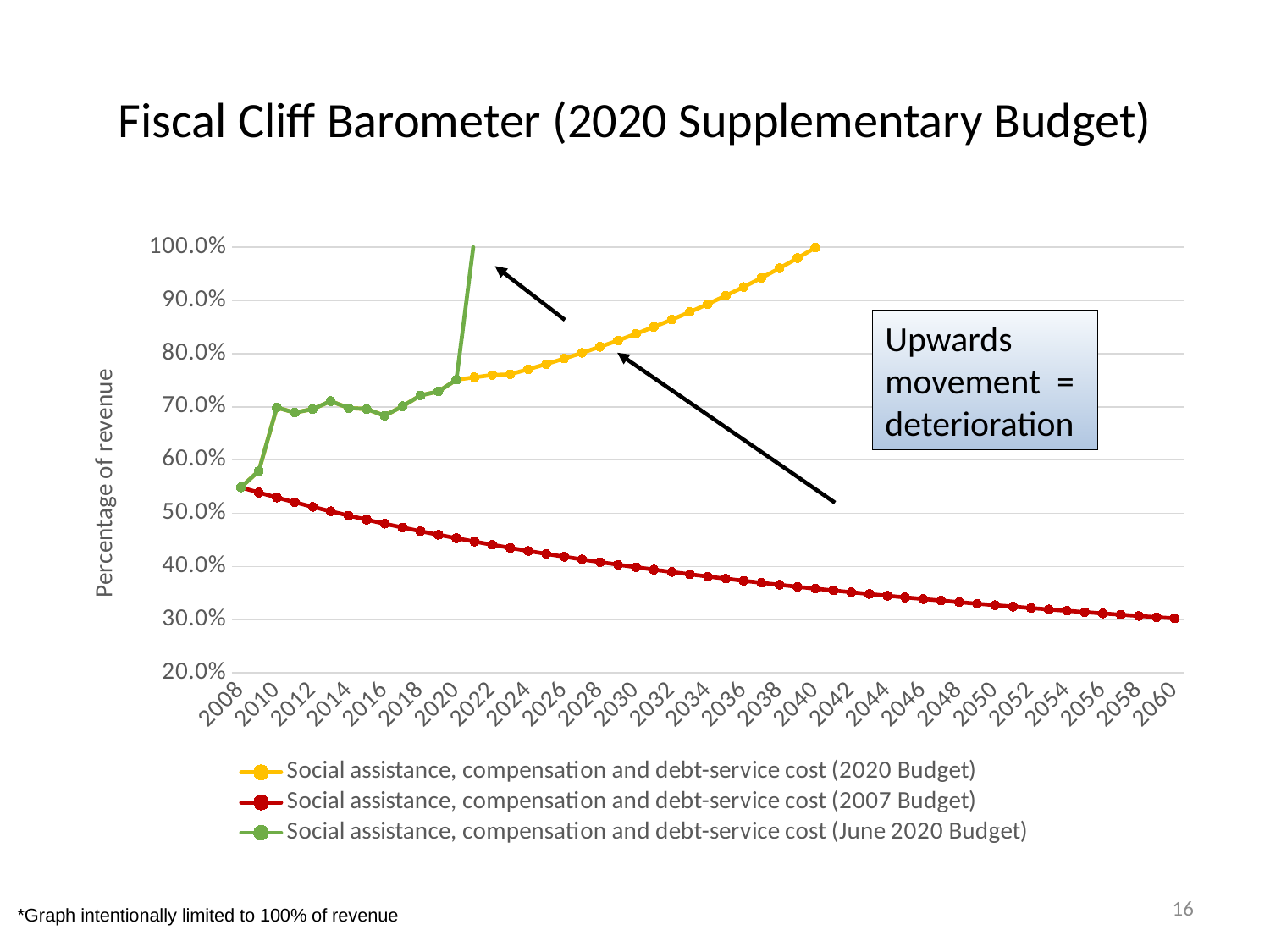
What is the title of the chart? Fiscal Cliff Barometer (2020 Supplementary Budget) Is the value for the June 2020 Budget series in 2008 greater or less than 50.0%? greater Is the value for the 2007 Budget series in 2020 greater or less than 50.0%? less How many series does the legend list? 3 Is the value for the 2007 Budget series in 2050 greater or less than 30.0%? greater Does the 'Social assistance, compensation and debt-service cost (2007 Budget)' series rise or fall from 2008 to 2060? fall Does the 'Social assistance, compensation and debt-service cost (2020 Budget)' series rise or fall from 2022 to 2040? rise Which series has the lowest value in 2040? Social assistance, compensation and debt-service cost (2007 Budget) In 2030, which series has the larger value: the 2020 Budget series or the 2007 Budget series? 2020 Budget series What is the label on the vertical axis of the chart? Percentage of revenue What kind of chart is shown on the slide? line chart